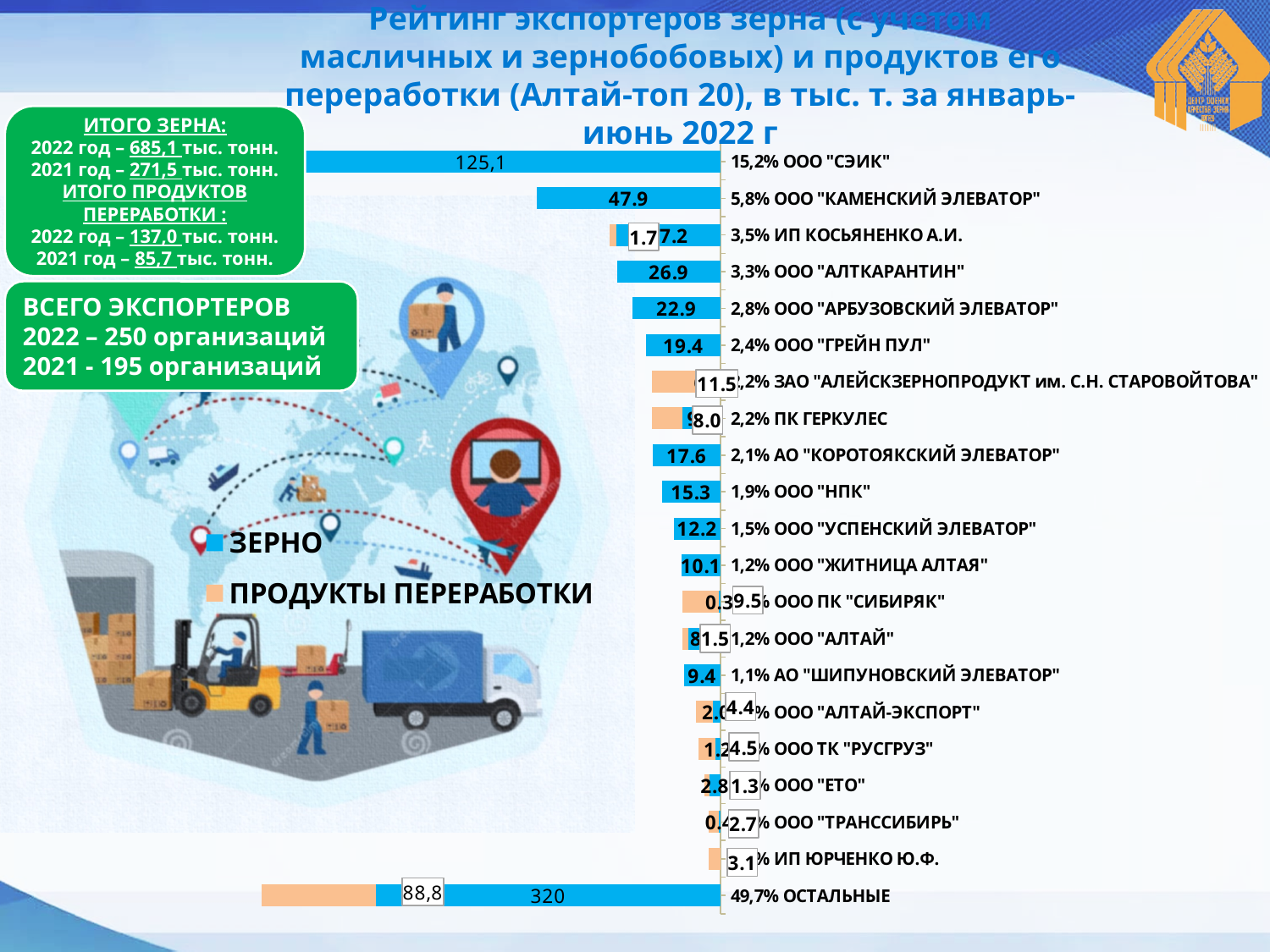
How many series does the chart legend list? 2 What are the two series named in the chart legend? ЗЕРНО and ПРОДУКТЫ ПЕРЕРАБОТКИ Which has a larger ЗЕРНО value: ООО "КАМЕНСКИЙ ЭЛЕВАТОР" or ООО "АЛТКАРАНТИН"? ООО "КАМЕНСКИЙ ЭЛЕВАТОР" What is the difference between the ЗЕРНО values of ООО "АРБУЗОВСКИЙ ЭЛЕВАТОР" and ООО "ГРЕЙН ПУЛ"? 3.5 What percentage share is shown next to ООО "СЭИК"? 15,2% What is the ЗЕРНО value for ООО "СЭИК"? 125,1 Which of the named exporters (excluding ОСТАЛЬНЫЕ) has the largest ЗЕРНО value? ООО "СЭИК" Which category has the largest ЗЕРНО value? ОСТАЛЬНЫЕ What kind of chart is shown on the slide? bar chart What is the ЗЕРНО value for ООО "АЛТКАРАНТИН"? 26.9 What is the ПРОДУКТЫ ПЕРЕРАБОТКИ value for ОСТАЛЬНЫЕ? 88,8 What is the ЗЕРНО value for ООО "КАМЕНСКИЙ ЭЛЕВАТОР"? 47.9